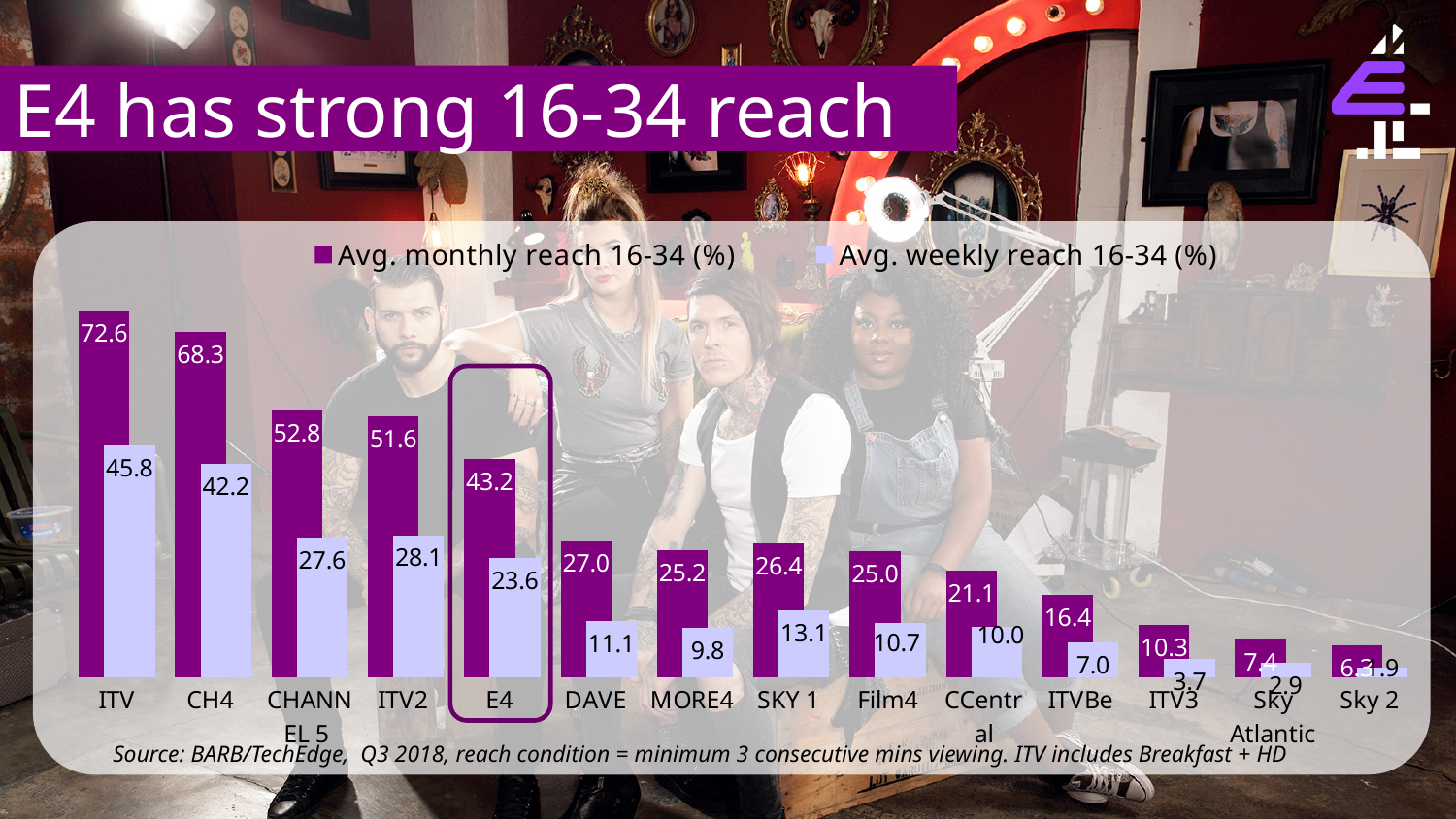
What is the average weekly reach 16-34 (%) for ITVBe? 7.0 Do the average monthly reach 16-34 (%) values generally rise or fall from left to right across the channels? Fall What kind of chart is shown on the slide? Bar chart What is the average monthly reach 16-34 (%) for E4? 43.2 What is the difference between ITV's and CH4's average monthly reach 16-34 (%)? 4.3 Which channel has the highest average monthly reach 16-34 (%)? ITV How many channels are shown on the chart? 14 Which channel has the lowest average weekly reach 16-34 (%)? Sky 2 What is the average weekly reach 16-34 (%) for ITV? 45.8 What is the difference between E4's average monthly reach and its average weekly reach 16-34 (%)? 19.6 How many series does the legend list? 2 Which has the larger average weekly reach 16-34 (%), CH4 or CHANNEL 5? CH4